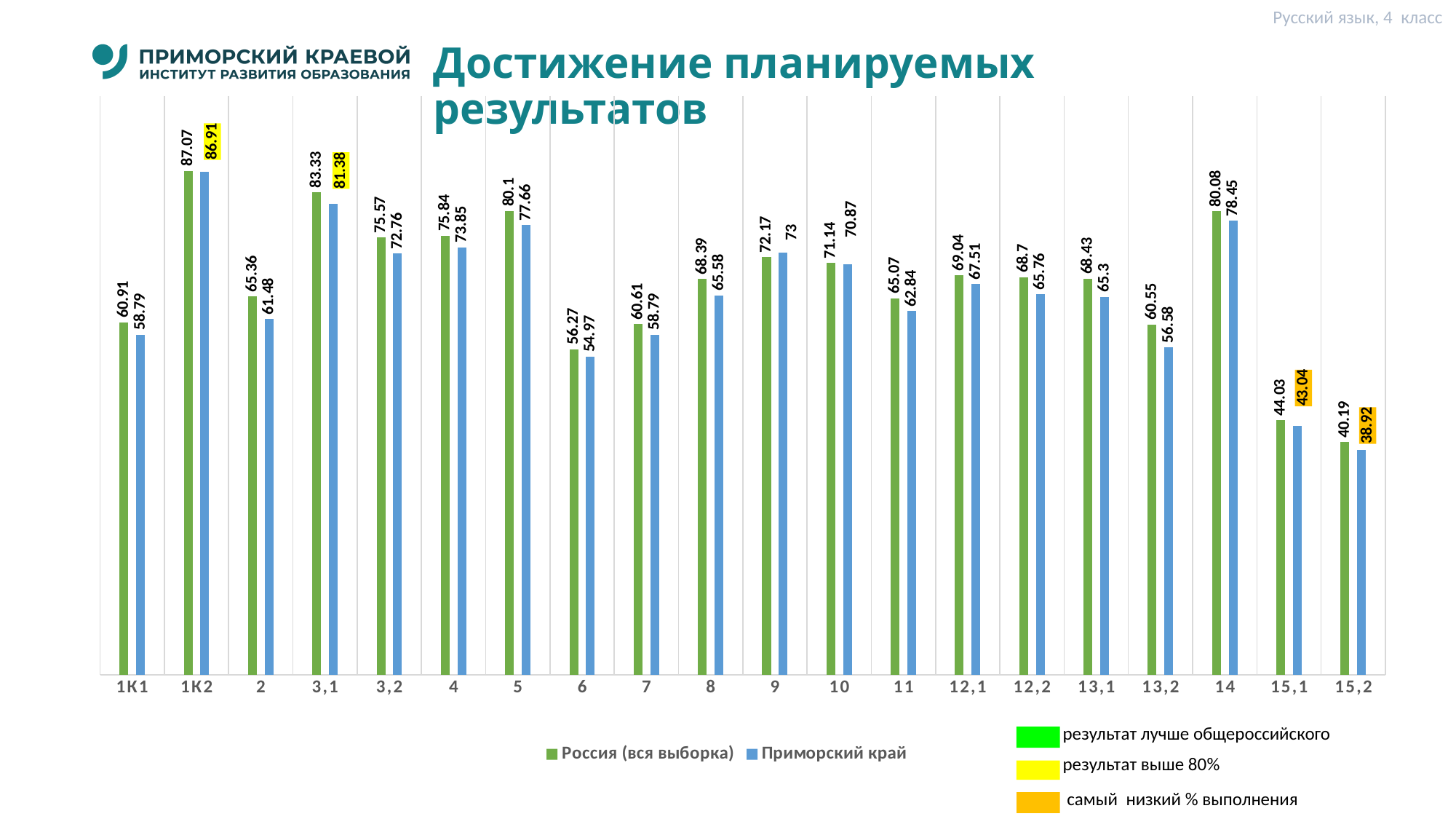
Which category has the highest value for Россия (вся выборка)? 1К2 Which category has the lowest value for Приморский край? 15,2 Which colour represents the Приморский край series? blue What is the value for Россия (вся выборка) for category 3,1? 83.33 What kind of chart is shown on the slide? bar chart What is the difference between the Россия (вся выборка) and Приморский край values for category 13,2? 3.97 What is the value for Приморский край for category 1К2? 86.91 How many categories are shown on the x axis? 20 For category 9, which series has the larger value: Россия (вся выборка) or Приморский край? Приморский край What is the value for Приморский край for category 9? 73 Which is larger: the Приморский край value for category 5 or for category 14? category 14 How many series does the legend list? 2